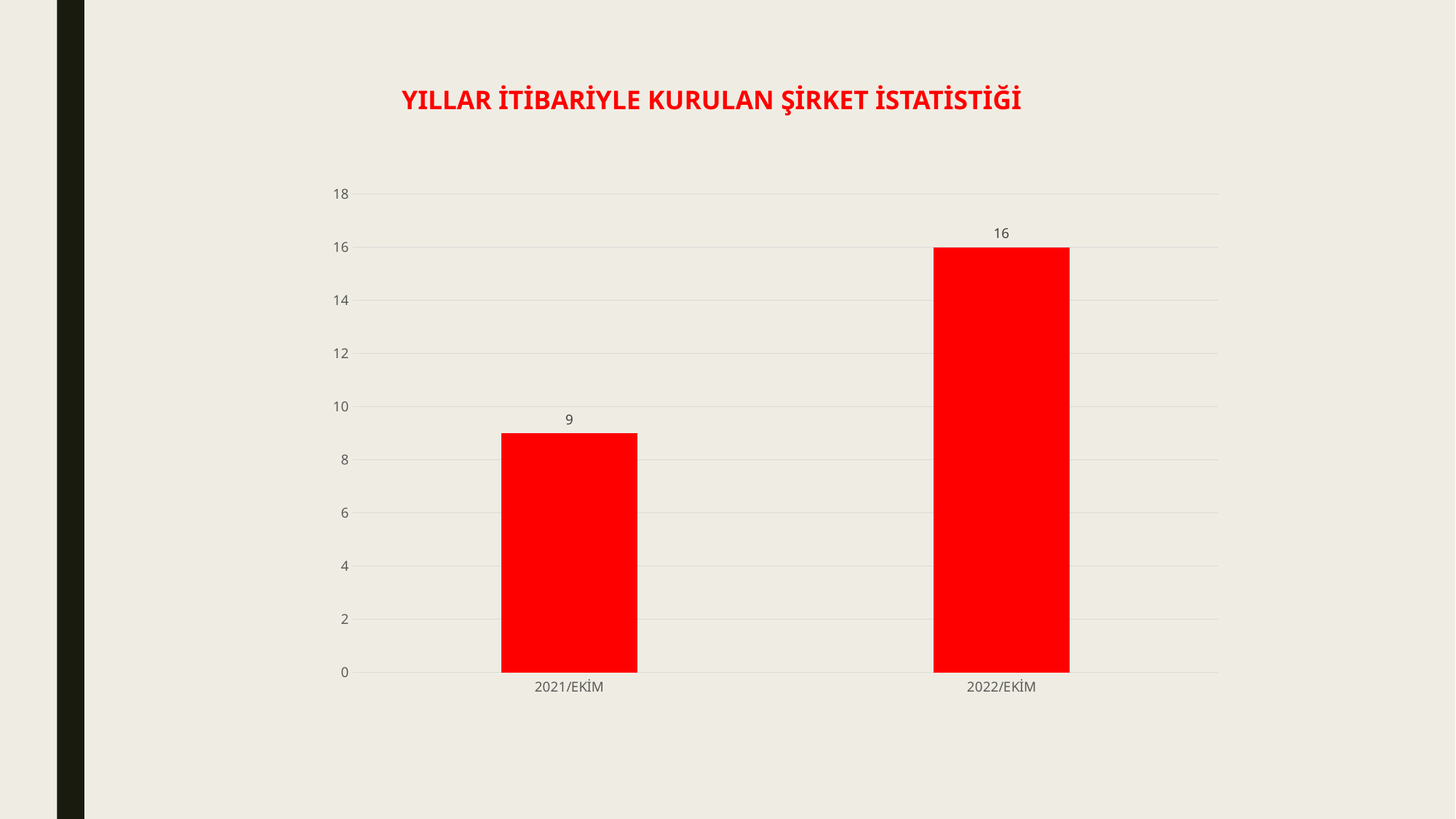
What is the value for 2022/EKİM? 16 What is the title of the chart? YILLAR İTİBARİYLE KURULAN ŞİRKET İSTATİSTİĞİ Which is larger, the value for 2021/EKİM or the value for 2022/EKİM? 2022/EKİM What is the value for 2021/EKİM? 9 Is the value for 2021/EKİM greater or less than 10? less Which category has the lowest value? 2021/EKİM Is the value for 2022/EKİM greater or less than 14? greater What kind of chart is shown on the slide? bar chart What is the difference between the values for 2022/EKİM and 2021/EKİM? 7 Which category has the highest value? 2022/EKİM Do the values rise or fall from 2021/EKİM to 2022/EKİM? rise How many categories are shown on the x axis? 2